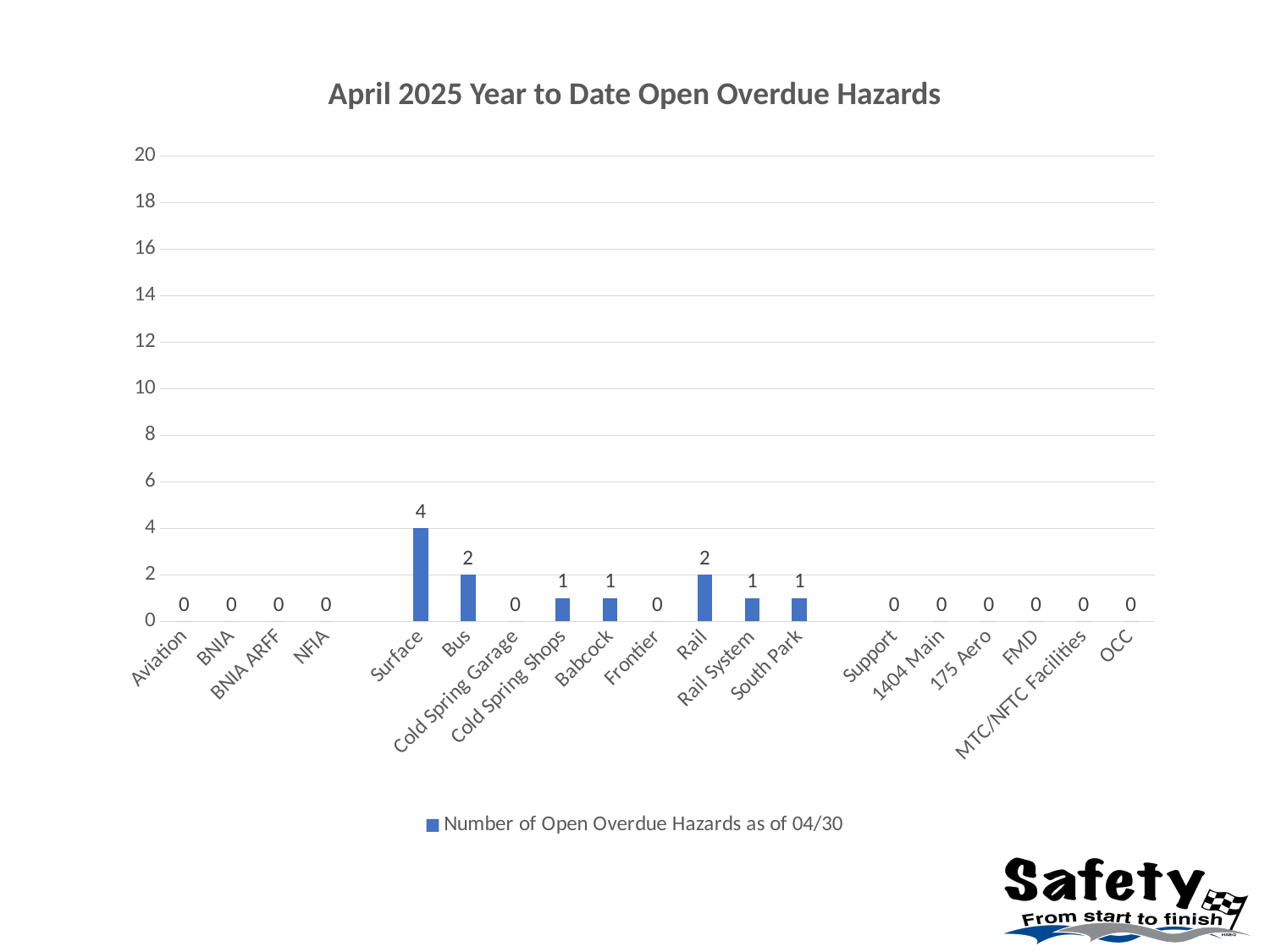
How many categories are shown on the x axis? 19 Is the value for Surface greater or less than 6? less What is the value for Surface? 4 What kind of chart is shown on the slide? Bar chart What is the value for Bus? 2 How many series does the legend list? 1 Which category has the highest number of open overdue hazards? Surface What is the value for Rail? 2 Which is larger, the value for Bus or the value for Rail System? Bus What is the difference between the values for Surface and Bus? 2 What is the value for Cold Spring Shops? 1 What is the value for Frontier? 0